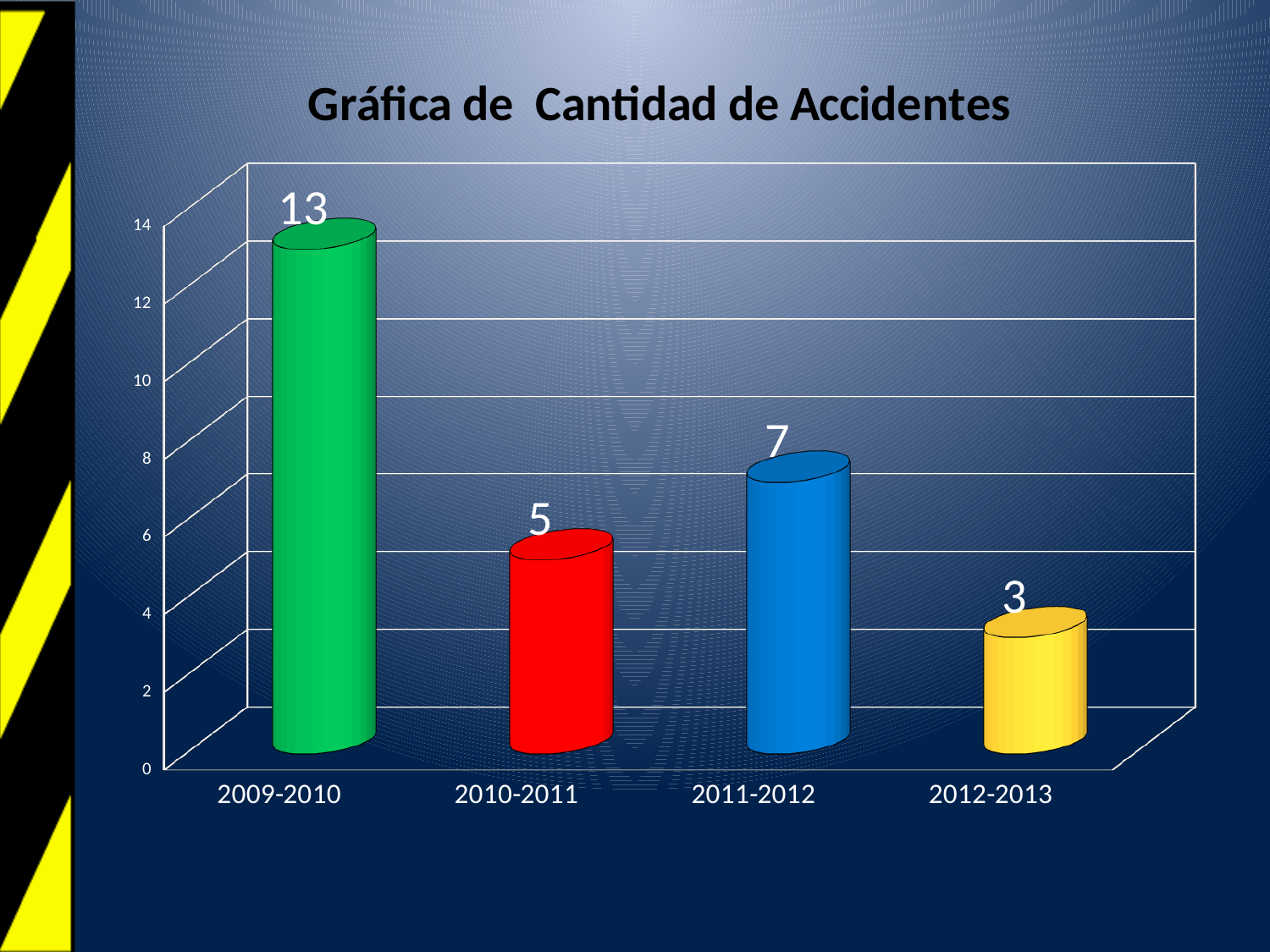
How many periods are shown on the x axis? 4 What is the difference between the values for 2011-2012 and 2010-2011? 2 What is the value for 2010-2011? 5 What is the value for 2009-2010? 13 What kind of chart is shown on the slide? Bar chart Which is larger, the value for 2010-2011 or the value for 2011-2012? 2011-2012 What is the difference between the values for 2009-2010 and 2012-2013? 10 Which period has the lowest number of accidents? 2012-2013 Which period has the highest number of accidents? 2009-2010 What is the title of the chart? Gráfica de Cantidad de Accidentes What is the value for 2011-2012? 7 What is the value for 2012-2013? 3